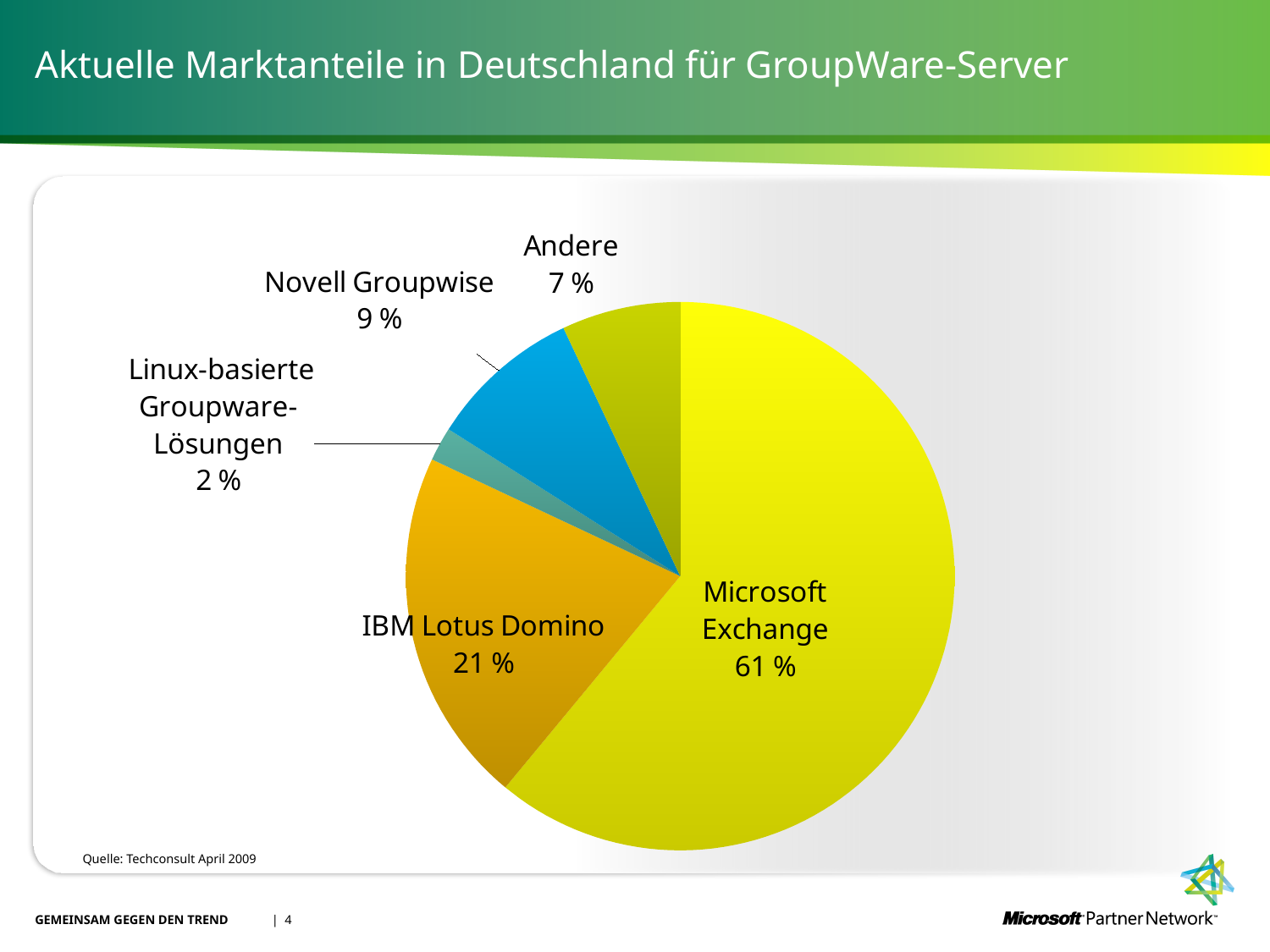
What share is shown for Linux-basierte Groupware-Lösungen? 2 % What is the title of the chart on the slide? Aktuelle Marktanteile in Deutschland für GroupWare-Server Which category has the largest share of the pie? Microsoft Exchange How many percentage points larger is Microsoft Exchange's share than IBM Lotus Domino's? 40 Which category has the smallest share of the pie? Linux-basierte Groupware-Lösungen How many categories are shown in the pie chart? 5 What share of the market does Microsoft Exchange hold? 61 % What kind of chart is shown on the slide? Pie chart Which has the larger share, Novell Groupwise or Andere? Novell Groupwise What share of the market does IBM Lotus Domino hold? 21 % What share of the market does Novell Groupwise hold? 9 % What share is shown for Andere? 7 %